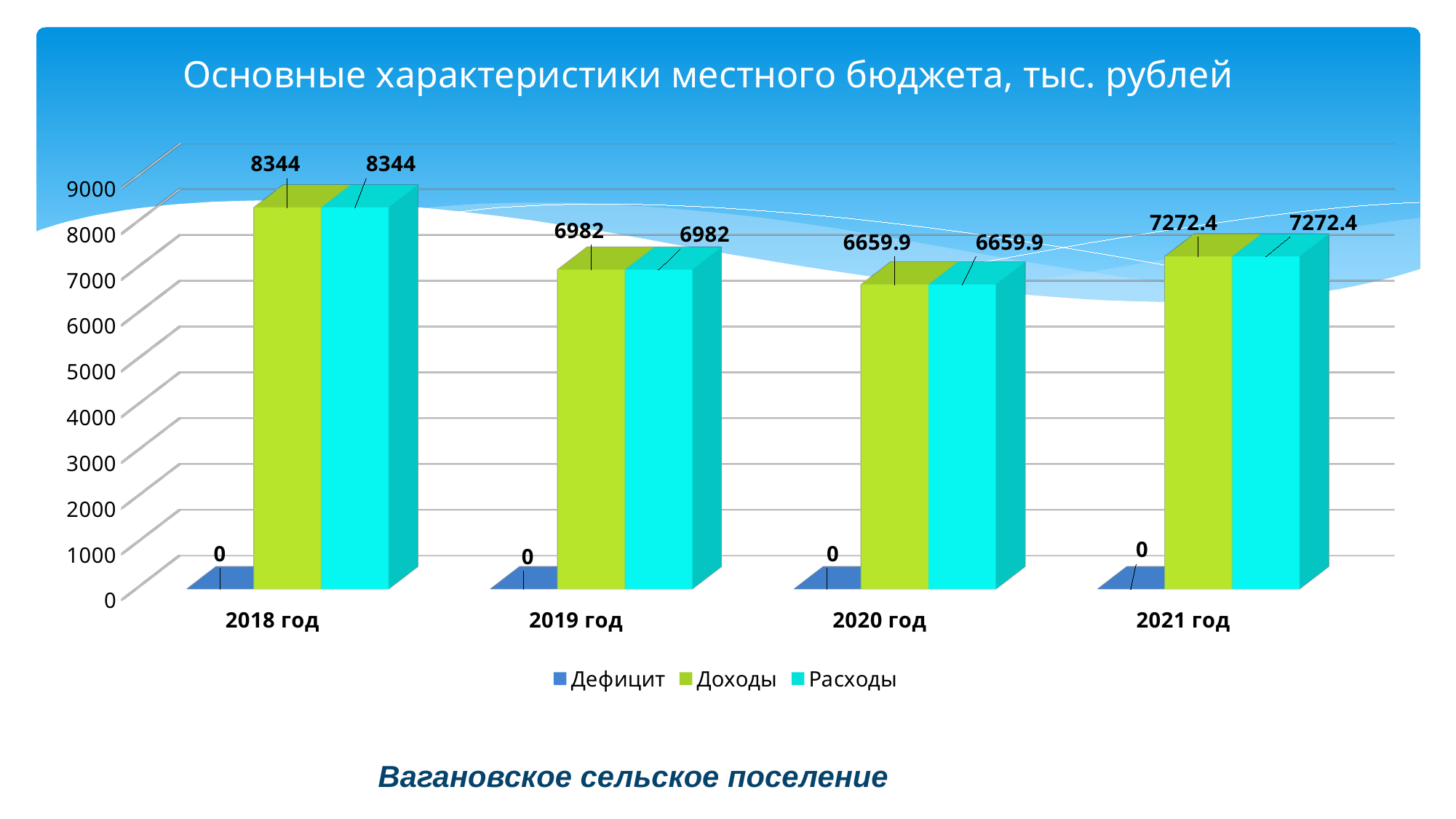
What is the title of the chart? Основные характеристики местного бюджета, тыс. рублей How many series does the legend list? 3 Which is larger: Расходы in 2021 год or Расходы in 2019 год? 2021 год How many years are shown on the x axis? 4 What kind of chart is shown on the slide? bar chart What is the value of Доходы for 2021 год? 7272.4 In which year is Расходы lowest? 2020 год What is the value of Доходы for 2018 год? 8344 What is the difference between Доходы in 2018 год and Доходы in 2019 год? 1362 What is the value of Дефицит for 2019 год? 0 What is the value of Расходы for 2020 год? 6659.9 In which year is Доходы highest? 2018 год